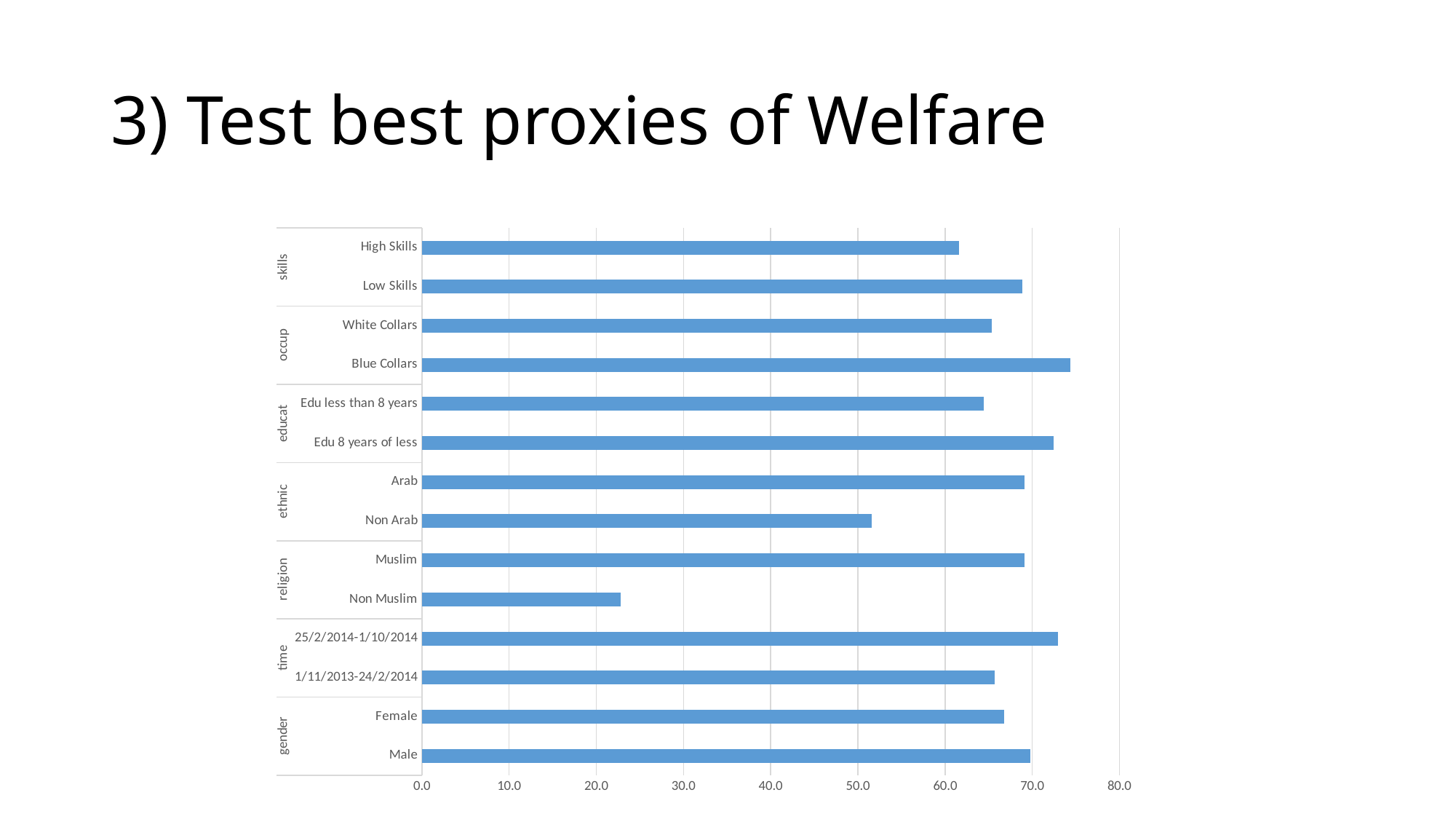
Which has the larger value, White Collars or Blue Collars? Blue Collars Which category has the lowest value in the chart? Non Muslim Which has the larger value, Arab or Non Arab? Arab Which has the larger value, Low Skills or High Skills? Low Skills Is the value for Non Muslim greater or less than 30? less Is the value for Blue Collars greater or less than 70? greater Is the value for Non Arab greater or less than 50? greater What kind of chart is shown on the slide? bar chart Which category has the highest value in the chart? Blue Collars How many group labels (such as skills, occup, educat) are shown along the vertical axis of the chart? 7 How many categories (bars) are plotted in the chart? 14